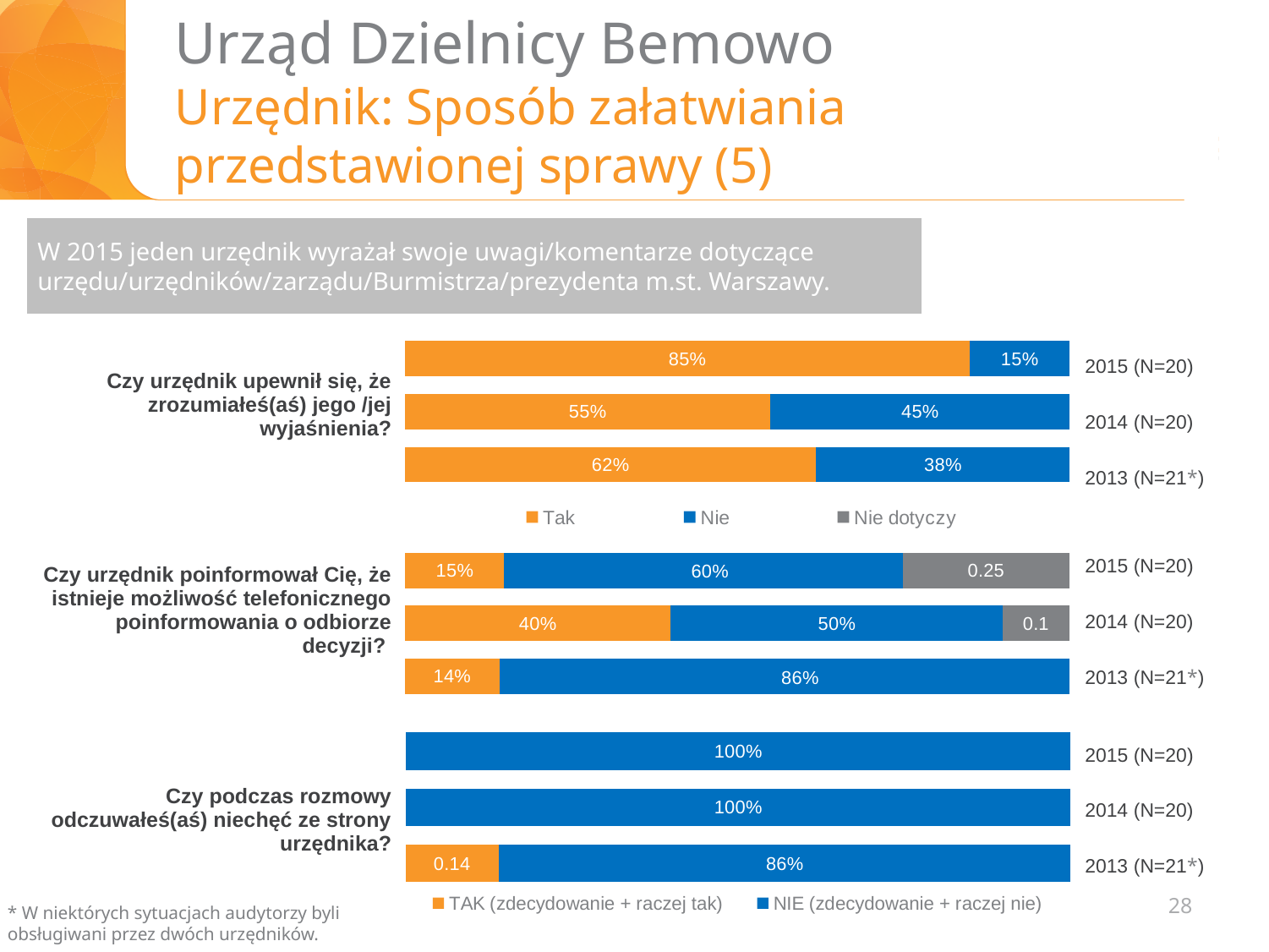
In the chart for "Czy urzędnik poinformował Cię, że istnieje możliwość telefonicznego poinformowania o odbiorze decyzji?", what is the Nie dotyczy value for 2015 (N=20)? 0.25 In the chart for "Czy podczas rozmowy odczuwałeś(aś) niechęć ze strony urzędnika?", what is the NIE value for 2015 (N=20)? 100% In the chart for "Czy urzędnik upewnił się, że zrozumiałeś(aś) jego /jej wyjaśnienia?", which year has the highest Tak value? 2015 (N=20) In the chart for "Czy urzędnik poinformował Cię, że istnieje możliwość telefonicznego poinformowania o odbiorze decyzji?", what is the Nie value for 2013 (N=21*)? 86% In the chart for "Czy urzędnik upewnił się, że zrozumiałeś(aś) jego /jej wyjaśnienia?", what is the difference between the Tak values for 2015 and 2014? 30 percentage points In the chart for "Czy urzędnik poinformował Cię, że istnieje możliwość telefonicznego poinformowania o odbiorze decyzji?", which year has the lowest Tak value? 2013 (N=21*) In the chart for "Czy urzędnik poinformował Cię, że istnieje możliwość telefonicznego poinformowania o odbiorze decyzji?", is the Tak value larger for 2014 or 2015? 2014 In the chart for "Czy urzędnik upewnił się, że zrozumiałeś(aś) jego /jej wyjaśnienia?", what is the Tak value for 2015 (N=20)? 85% In the chart for "Czy urzędnik upewnił się, że zrozumiałeś(aś) jego /jej wyjaśnienia?", what is the Nie value for 2014 (N=20)? 45% What type of chart is used for "Czy podczas rozmowy odczuwałeś(aś) niechęć ze strony urzędnika?"? Stacked bar chart How many series does the legend list for the chart "Czy urzędnik poinformował Cię, że istnieje możliwość telefonicznego poinformowania o odbiorze decyzji?"? 3 In the chart for "Czy podczas rozmowy odczuwałeś(aś) niechęć ze strony urzędnika?", what is the TAK value for 2013 (N=21*)? 0.14